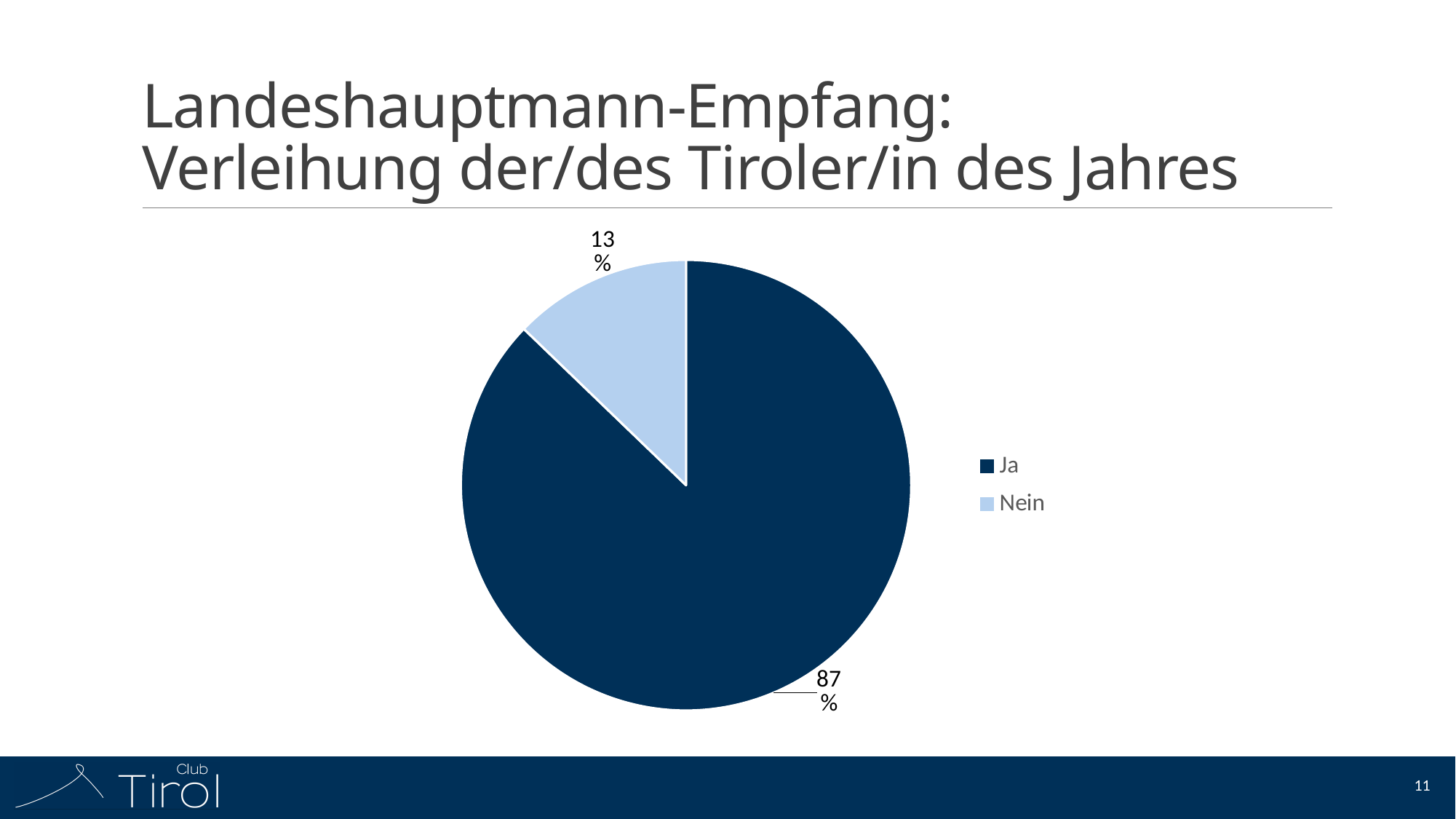
What kind of chart is shown on the slide? pie chart Which slice is the smallest? Nein What is the difference in percentage points between the "Ja" and "Nein" slices? 74 Which is larger, the "Ja" slice or the "Nein" slice? Ja What colour is the "Nein" slice? light blue How many slices does the pie chart have? 2 What is the title of the slide containing the pie chart? Landeshauptmann-Empfang: Verleihung der/des Tiroler/in des Jahres How many entries does the legend list? 2 What share of the pie does "Ja" have? 87% What share of the pie does "Nein" have? 13% Which slice is the largest? Ja